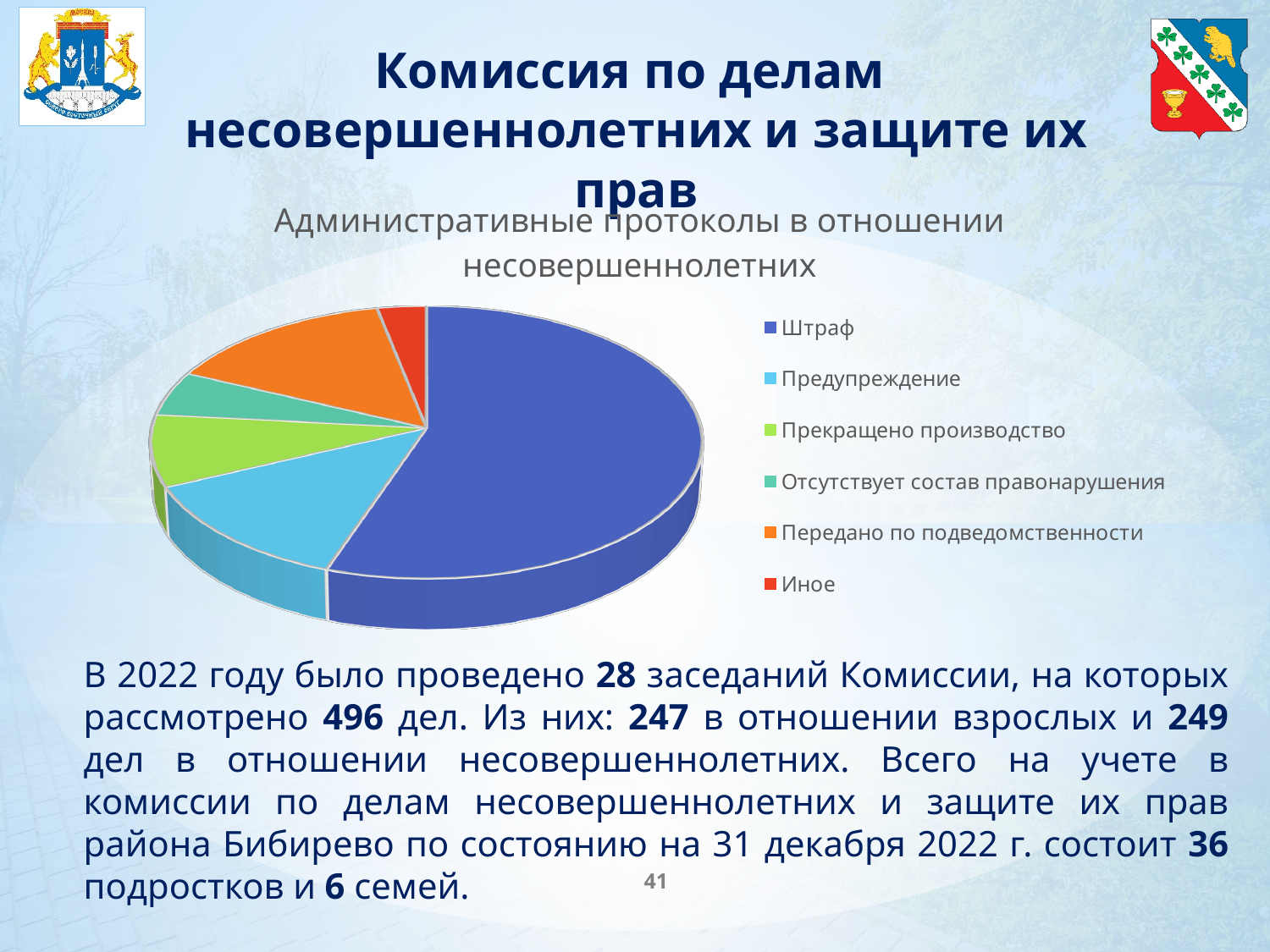
Which category has the smallest slice of the pie? Иное How many categories does the pie chart show? 6 Which slice is larger, Штраф or Передано по подведомственности? Штраф What colour is the slice for Штраф? blue What kind of chart is shown on the slide? pie chart What is the title of the chart? Административные протоколы в отношении несовершеннолетних Which category has the largest slice of the pie? Штраф Which slice is larger, Штраф or Предупреждение? Штраф Which slice is larger, Передано по подведомственности or Иное? Передано по подведомственности